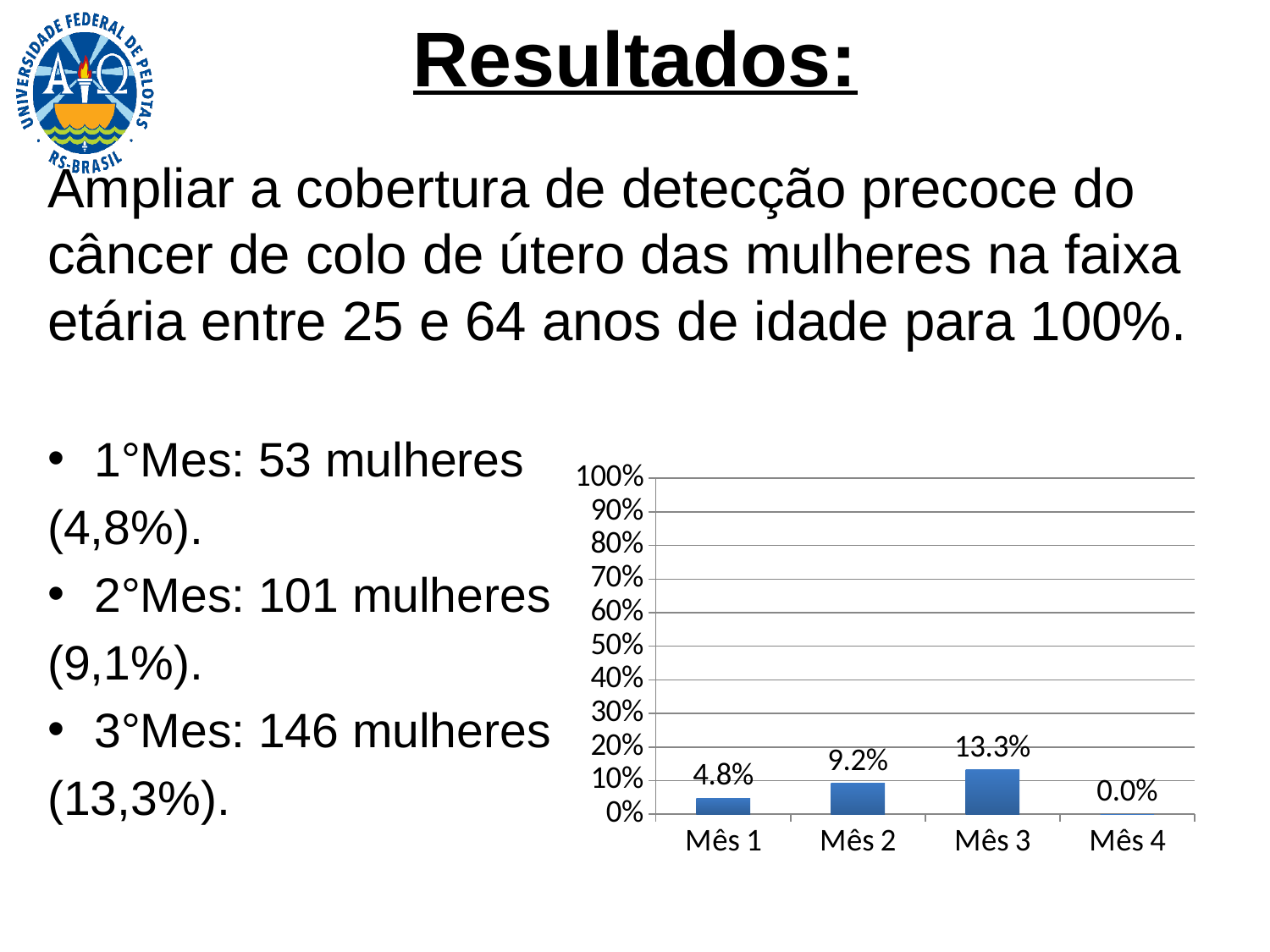
Which month has the lowest value? Mês 4 What is the difference between the values for Mês 3 and Mês 1? 8.5% How many categories are shown on the x axis? 4 What is the value for Mês 1? 4.8% Which is larger, the value for Mês 2 or the value for Mês 1? Mês 2 What is the value for Mês 4? 0.0% What kind of chart is shown on the slide? bar chart What is the value for Mês 3? 13.3% What is the highest value shown on the y axis? 100% What is the value for Mês 2? 9.2% Is the value for Mês 3 greater or less than 20%? less Which month has the highest value? Mês 3